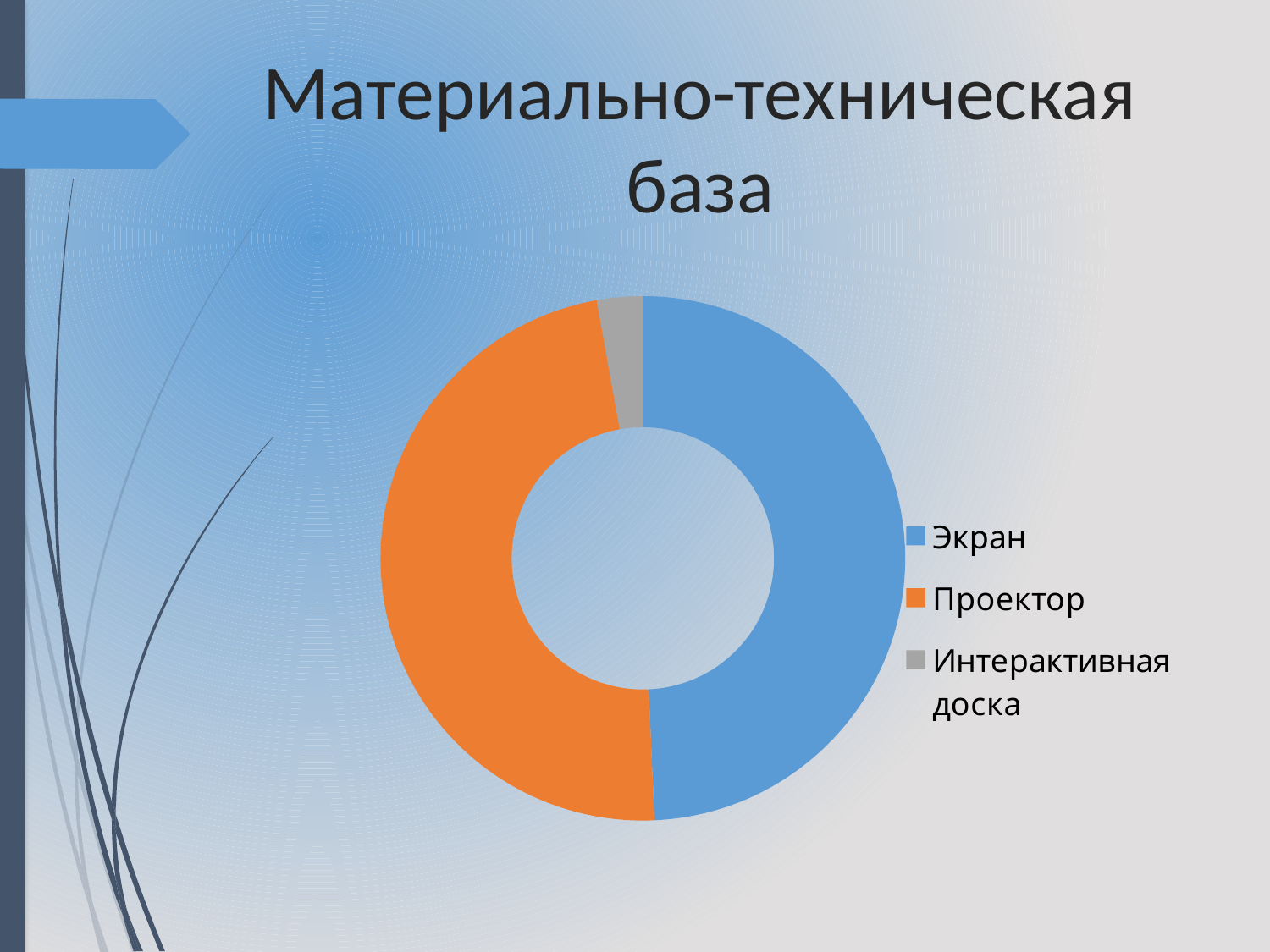
How many categories does the chart show? 3 What colour represents Проектор in the chart? orange Which is larger: the share for Экран or the share for Проектор? Экран Which category is shown in grey? Интерактивная доска Which is larger: the share for Проектор or the share for Интерактивная доска? Проектор Which category has the smallest share of the chart? Интерактивная доска Which category is shown in blue? Экран Which category has the largest share of the chart? Экран What kind of chart is shown on the slide? doughnut (pie) chart